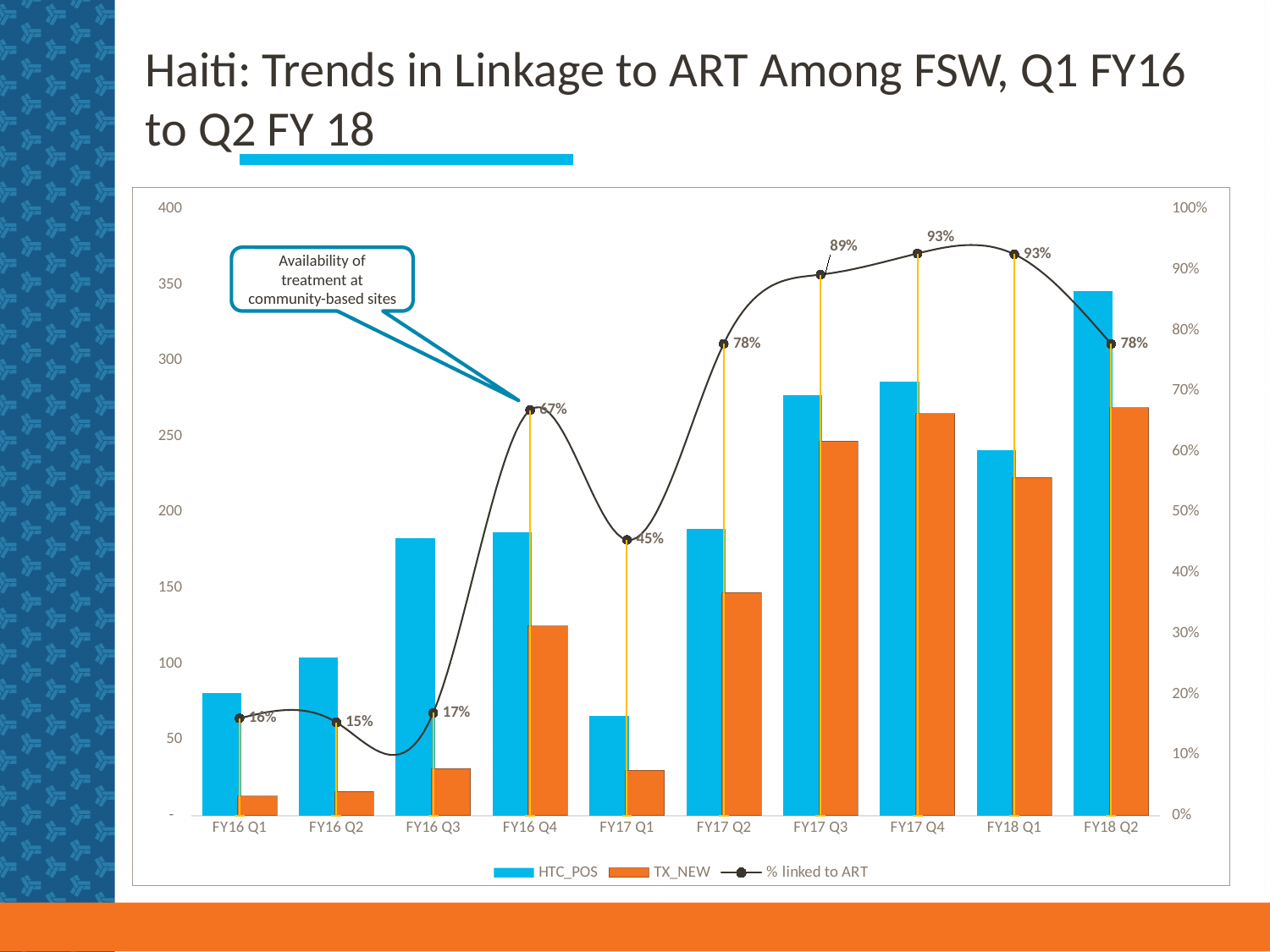
Is the TX_NEW value for FY16 Q1 greater or less than 50? less What is the % linked to ART value for FY16 Q4? 67% In which quarter is the % linked to ART lowest? FY16 Q2 Is the HTC_POS value for FY18 Q2 greater or less than 300? greater What kind of chart is this? Bar chart with a line series How many quarters are shown on the x axis? 10 How many series does the legend list? 3 Which is larger, the % linked to ART in FY16 Q4 or in FY17 Q1? FY16 Q4 What is the % linked to ART value for FY18 Q2? 78% What is the % linked to ART value for FY17 Q3? 89% What is the difference in % linked to ART between FY17 Q3 and FY17 Q2? 11 percentage points Which quarter has the tallest HTC_POS bar? FY18 Q2